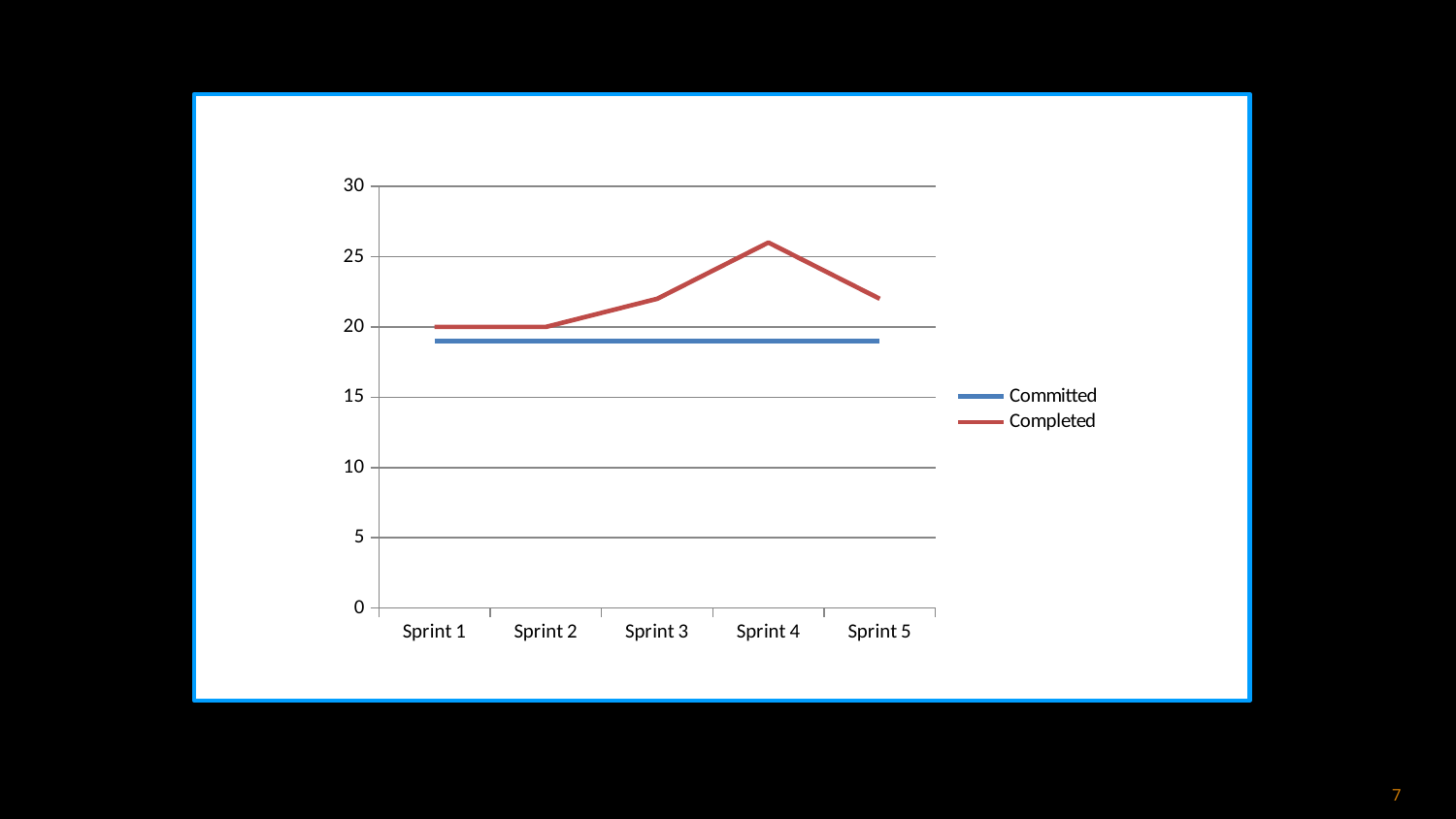
Which is larger for the Completed series, Sprint 3 or Sprint 4? Sprint 4 Does the Completed series rise or fall from Sprint 1 to Sprint 4? rise Is the Committed value for Sprint 3 greater or less than 20? less How many sprints are shown on the x axis? 5 Is the Completed value for Sprint 3 greater or less than 20? greater How many series does the legend list? 2 What colour is the Completed line in the legend? red What kind of chart is shown on the slide? line chart Is the Completed value for Sprint 4 greater or less than 25? greater Does the Committed series rise, fall, or stay flat across the sprints? stay flat Which is larger at Sprint 4, the Committed value or the Completed value? Completed In which sprint does the Completed series reach its highest value? Sprint 4